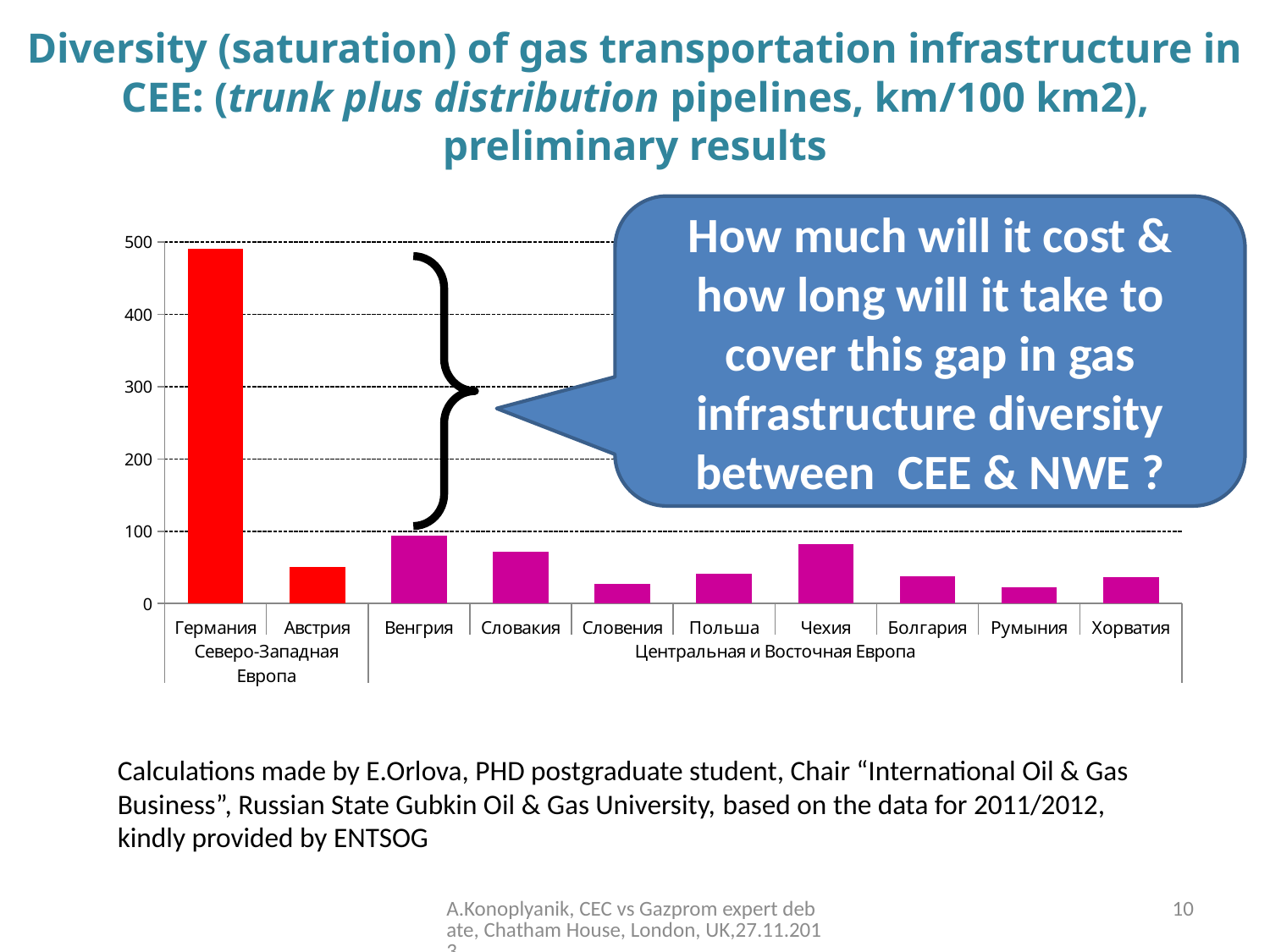
Which country has the highest bar on the chart? Германия Which is larger, the value for Словакия or the value for Польша? Словакия Is the value for Словения greater or less than 100? less How many countries are plotted on the chart? 10 What kind of chart is shown on the slide? bar chart Is the value for Австрия greater or less than 100? less What colour are the bars for the Северо-Западная Европа group (Германия and Австрия)? red Which is larger, the value for Венгрия or the value for Румыния? Венгрия Is the value for Чехия greater or less than 100? less Which is larger, the value for Германия or the value for Австрия? Германия